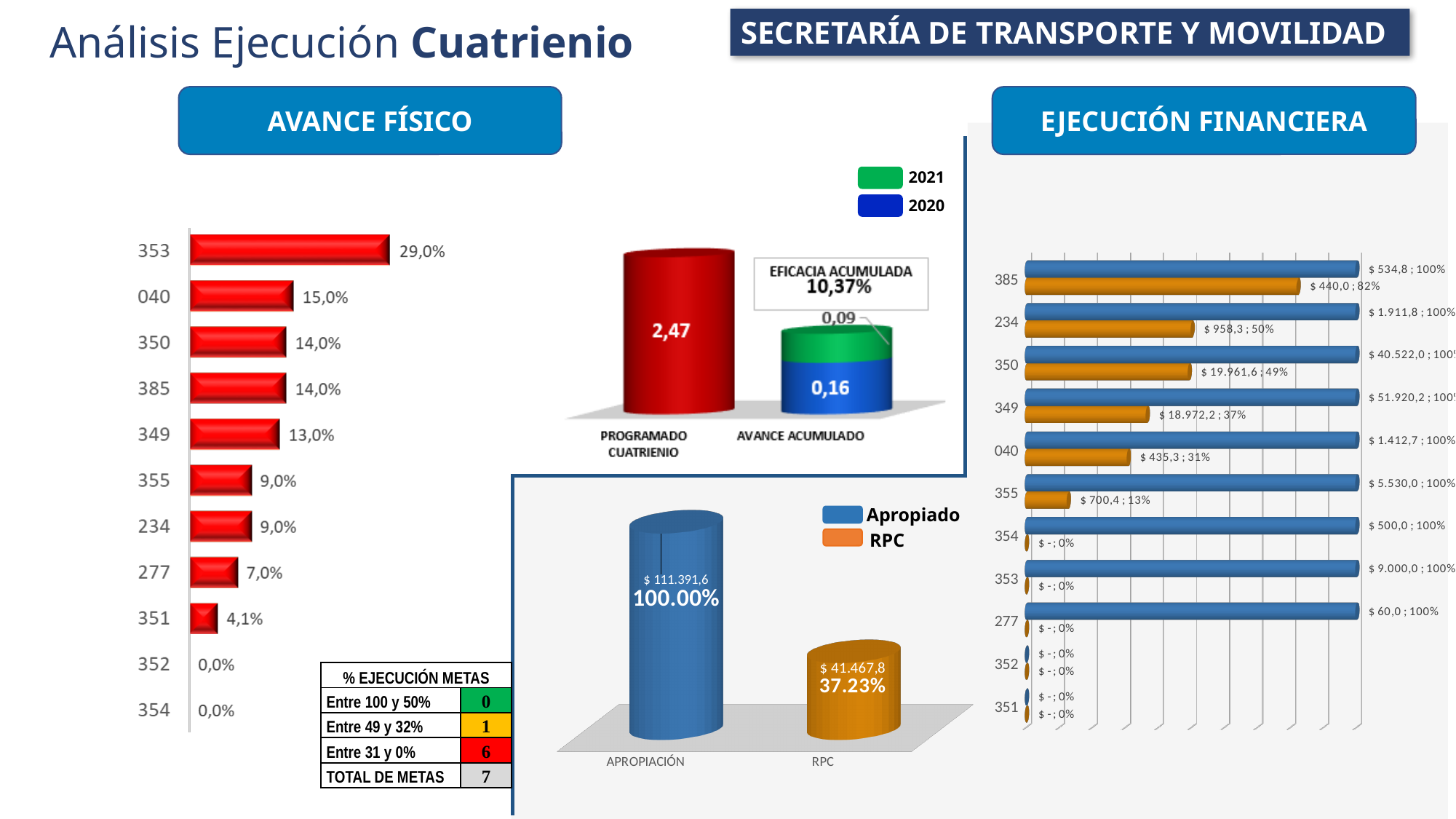
In the red horizontal bar chart under AVANCE FÍSICO, which category has the highest value? 353 In the cylinder chart with PROGRAMADO CUATRIENIO and AVANCE ACUMULADO, what is the total of the stacked AVANCE ACUMULADO bar? 0,25 In the cylinder chart with APROPIACIÓN and RPC, what percentage is shown for RPC? 37.23% In the cylinder chart with PROGRAMADO CUATRIENIO and AVANCE ACUMULADO, what is the 2020 value of AVANCE ACUMULADO? 0,16 In the red horizontal bar chart under AVANCE FÍSICO, what is the value for category 353? 29,0% In the red horizontal bar chart under AVANCE FÍSICO, how many categories are plotted? 11 In the cylinder chart with APROPIACIÓN and RPC, what kind of chart is it? bar chart In the red horizontal bar chart under AVANCE FÍSICO, which is larger, the value for 349 or the value for 351? 349 In the red horizontal bar chart under AVANCE FÍSICO, what is the difference between the values for 040 and 277? 8,0% In the cylinder chart with PROGRAMADO CUATRIENIO and AVANCE ACUMULADO, what is the value for PROGRAMADO CUATRIENIO? 2,47 In the horizontal bar chart under EJECUCIÓN FINANCIERA, what is the RPC value for category 350? $ 19.961,6 ; 49%